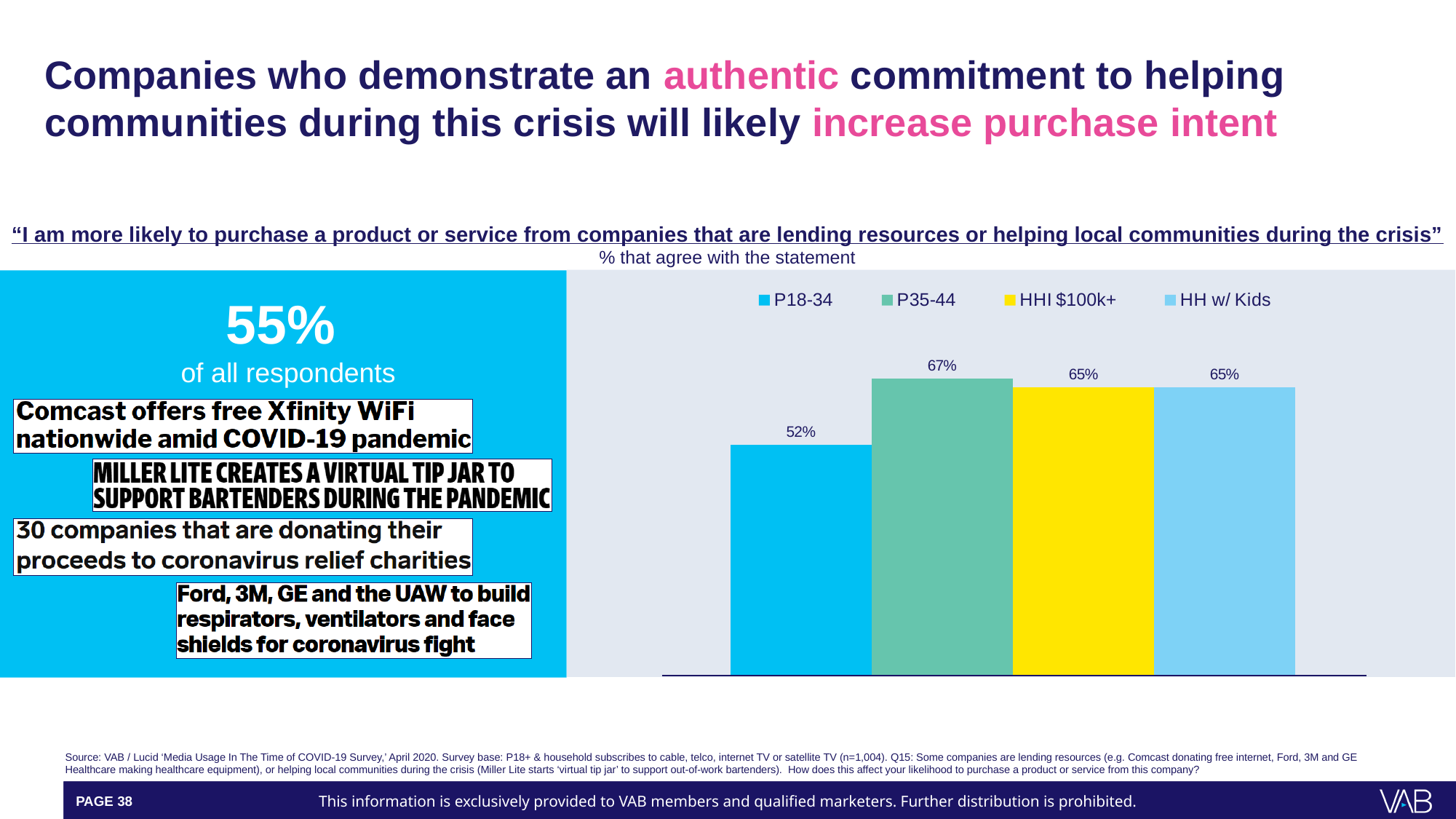
Which is larger, the value for P18-34 or the value for HH w/ Kids? HH w/ Kids What is the difference in percentage points between HHI $100k+ and P18-34? 13 What percentage of P35-44 respondents agree with the statement? 67% What percentage of HH w/ Kids respondents agree with the statement? 65% Which group has the highest share agreeing with the statement? P35-44 Which group has the lowest share agreeing with the statement? P18-34 What percentage of P18-34 respondents agree with the statement? 52% What kind of chart is shown on the slide? Bar chart What colour is the bar for HHI $100k+? Yellow How many series does the chart legend list? 4 What percentage of HHI $100k+ respondents agree with the statement? 65% What is the difference in percentage points between P35-44 and P18-34? 15